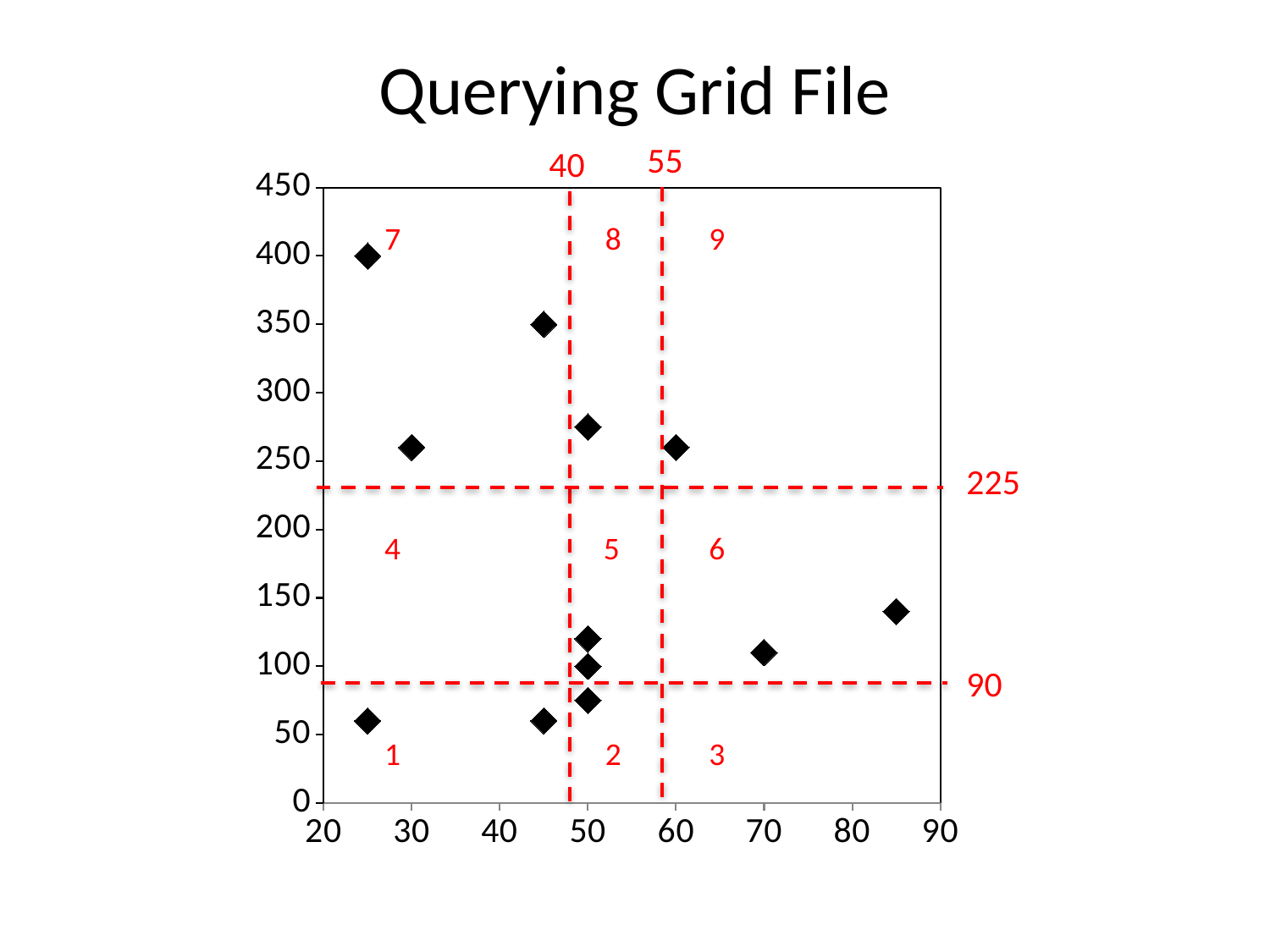
Is the y value of the lowest point near x = 25 greater or less than 100? less What is the title of the slide? Querying Grid File How many numbered grid cells are marked on the chart? 9 Is the y value of the point with the largest x value (near x = 85) greater or less than 150? less Is the y value of the point near x = 70 greater or less than 150? less What is the maximum value shown on the y axis? 450 How many data points are plotted on the chart? 12 Which has the larger y value: the point near x = 25 at the top of the chart or the point near x = 45 at the top of the chart? the point near x = 25 What value labels the horizontal red dashed line nearer the top of the chart? 225 What kind of chart is shown on the slide? scatter chart